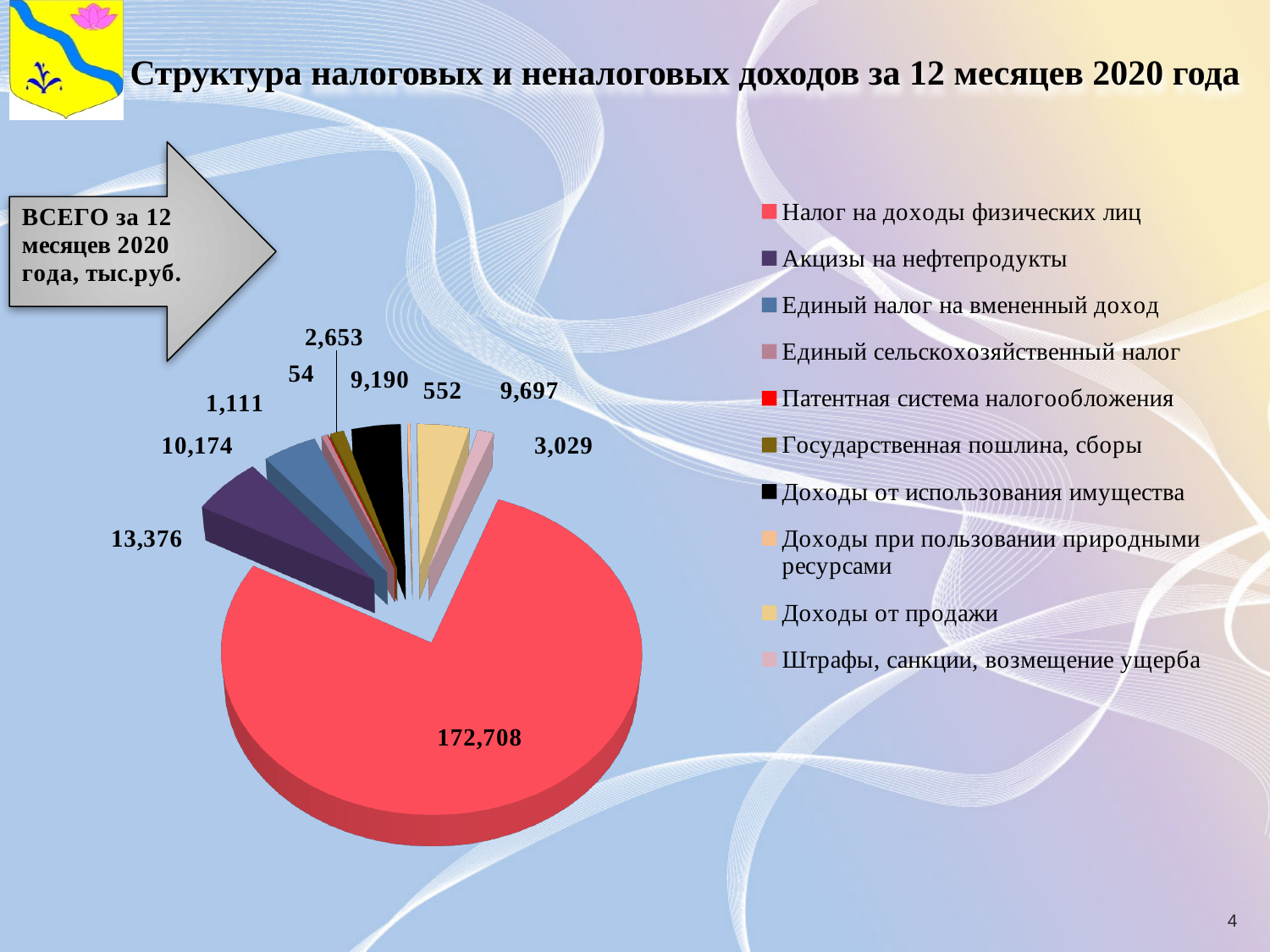
Which category has the largest slice of the pie? Налог на доходы физических лиц Which category has the smallest slice of the pie? Патентная система налогообложения What is the value for Акцизы на нефтепродукты? 13,376 What is the value for Налог на доходы физических лиц? 172,708 What is the value for Единый налог на вмененный доход? 10,174 Which is larger: Доходы от продажи or Доходы от использования имущества? Доходы от продажи What is the value for Доходы от продажи? 9,697 What is the value for Патентная система налогообложения? 54 What type of chart is shown on the slide? pie chart In what units are the values in the chart given, according to the arrow label? тыс.руб. How many categories does the legend of the pie chart list? 10 What is the difference between the values for Акцизы на нефтепродукты and Единый налог на вмененный доход? 3,202